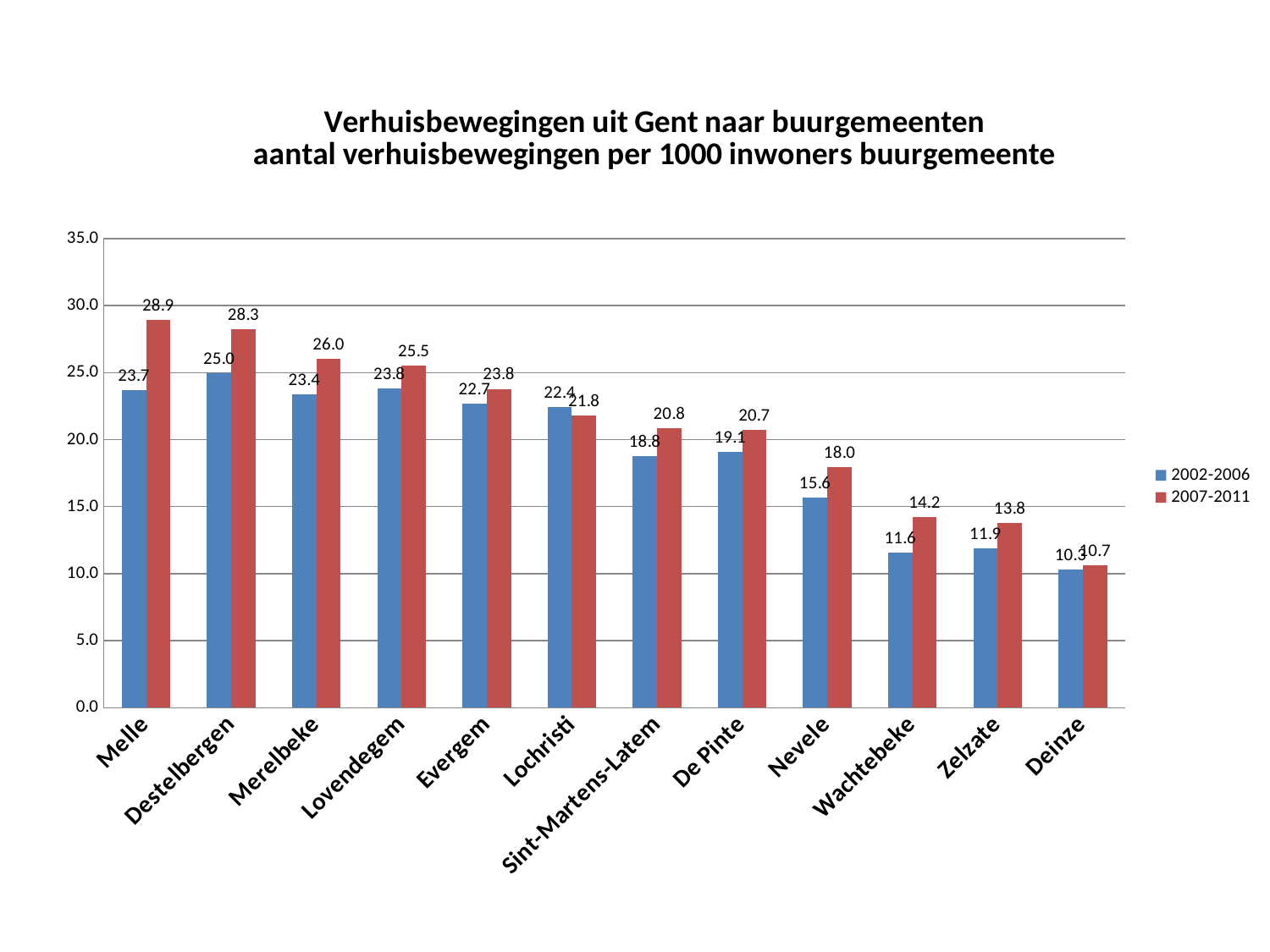
What is the value for Sint-Martens-Latem in the 2007-2011 series? 20.8 What is the value for Nevele in the 2002-2006 series? 15.6 What is the difference between the 2007-2011 and 2002-2006 values for Wachtebeke? 2.6 For Lochristi, which series has the larger value, 2002-2006 or 2007-2011? 2002-2006 What are the two series listed in the legend? 2002-2006 and 2007-2011 Do the 2007-2011 values generally rise or fall from left to right along the x axis? fall What is the value for Melle in the 2007-2011 series? 28.9 Which municipality has the lowest value in the 2002-2006 series? Deinze Which municipality has the highest value in the 2007-2011 series? Melle What kind of chart is shown on the slide? bar chart How many municipalities are shown on the x axis? 12 How many series does the legend list? 2